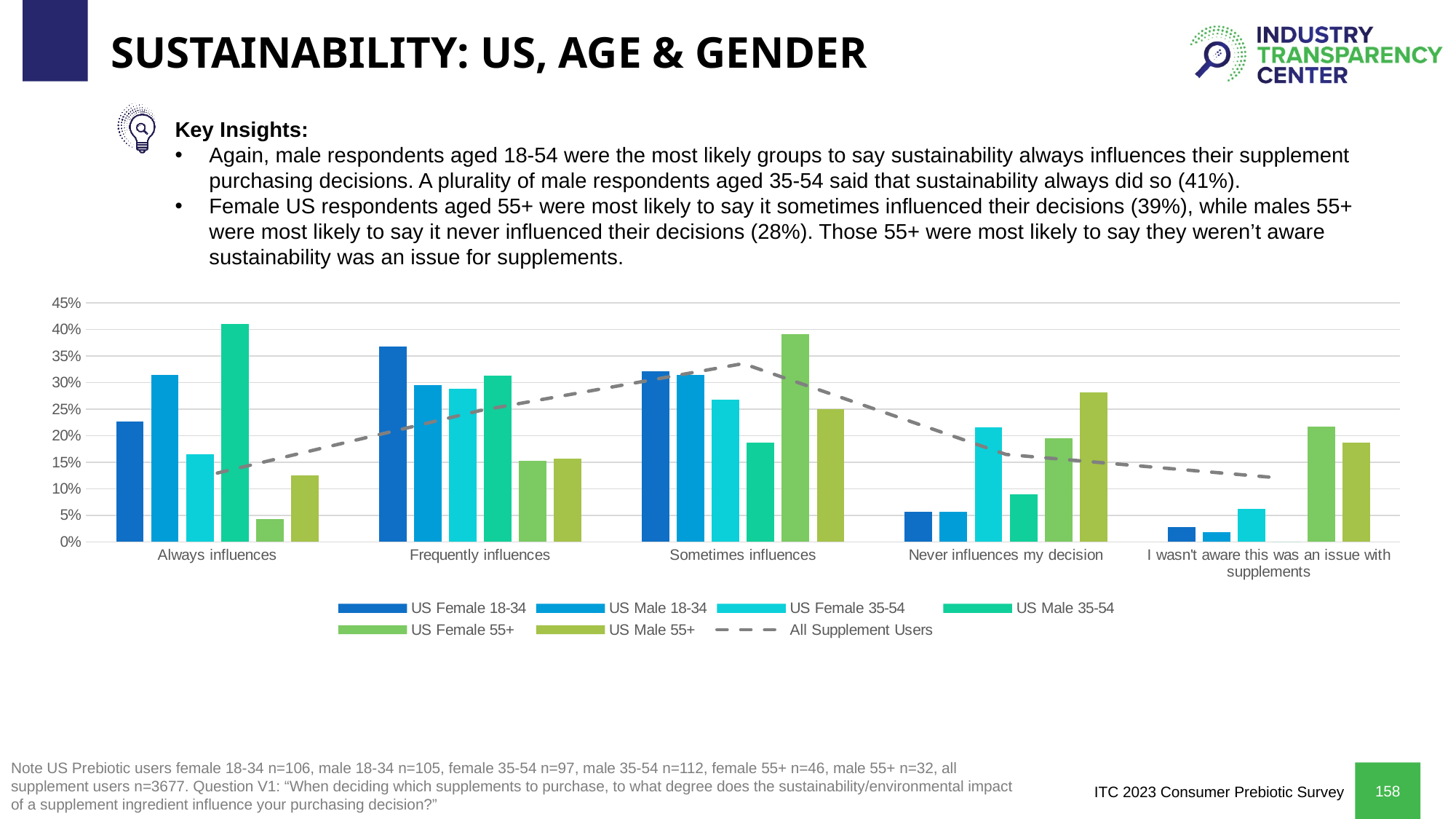
Which series has the lowest bar in the 'Always influences' category? US Female 55+ Which series has the highest bar in the 'Frequently influences' category? US Female 18-34 Is the value for US Male 35-54 in 'Never influences my decision' greater or less than 10%? less Does the 'All Supplement Users' dashed line rise or fall from 'Sometimes influences' to 'I wasn't aware this was an issue with supplements'? fall In the 'Always influences' category, which is larger: US Male 18-34 or US Female 35-54? US Male 18-34 How many series does the legend list? 7 Is the value for US Male 55+ in 'Never influences my decision' greater or less than 25%? greater Which series has the highest bar in the 'Always influences' category? US Male 35-54 Which series has the highest bar in the 'Sometimes influences' category? US Female 55+ How many response categories are shown along the x axis? 5 What kind of chart is shown on the slide? combination bar and line chart